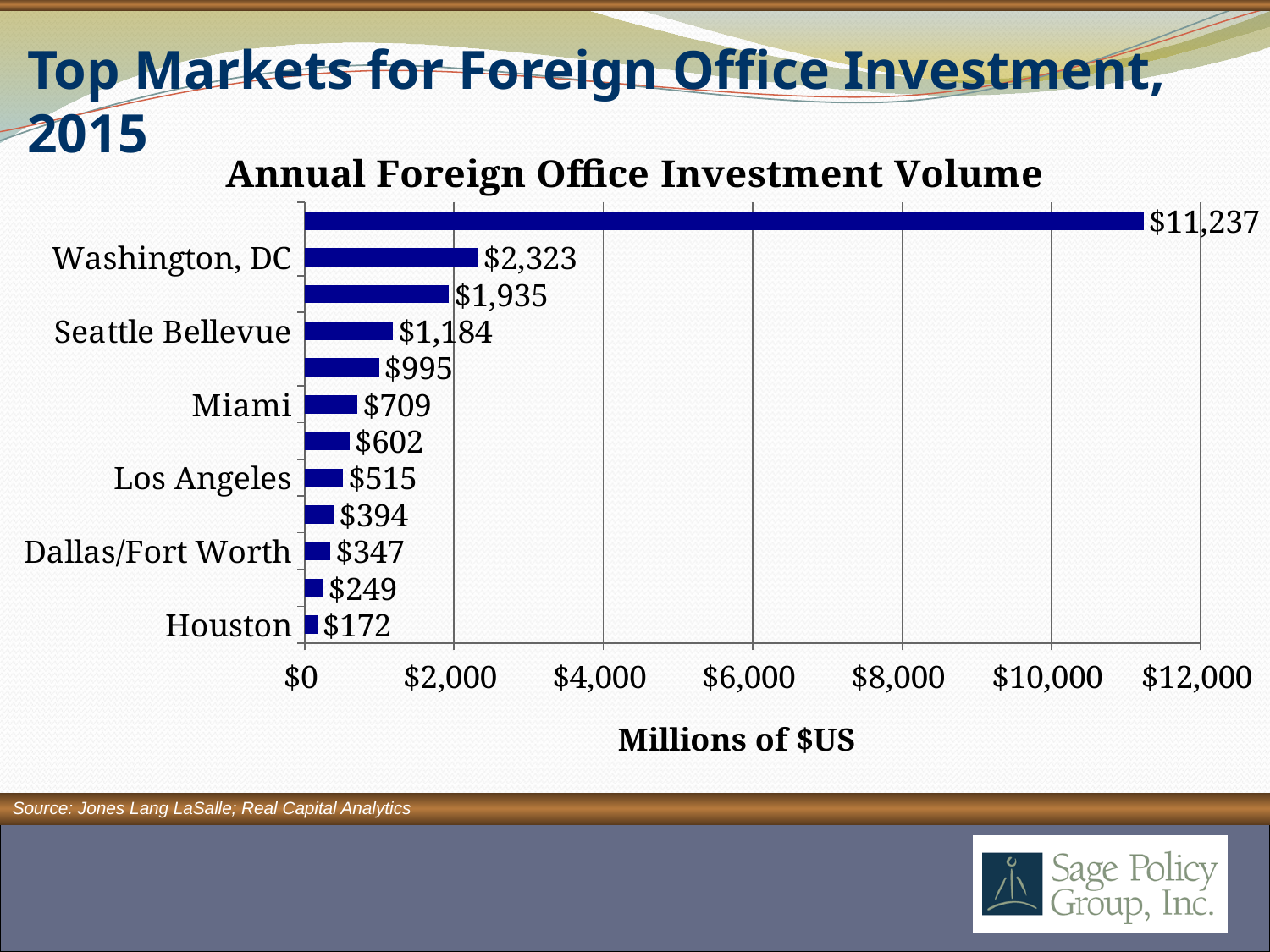
What is the value shown for Seattle Bellevue? $1,184 What is the difference between the values for Washington, DC and Seattle Bellevue? $1,139 What is the annual foreign office investment volume for Washington, DC? $2,323 Which labeled market has the lowest foreign office investment volume? Houston What is the largest value labeled on any bar in the chart? $11,237 What is the value shown for Miami? $709 How many bars are plotted in the chart? 12 What is the value shown for Dallas/Fort Worth? $347 What is the x-axis label of the chart? Millions of $US What is the value shown for Los Angeles? $515 Which has a larger value, Miami or Los Angeles? Miami What kind of chart is shown on the slide? Bar chart